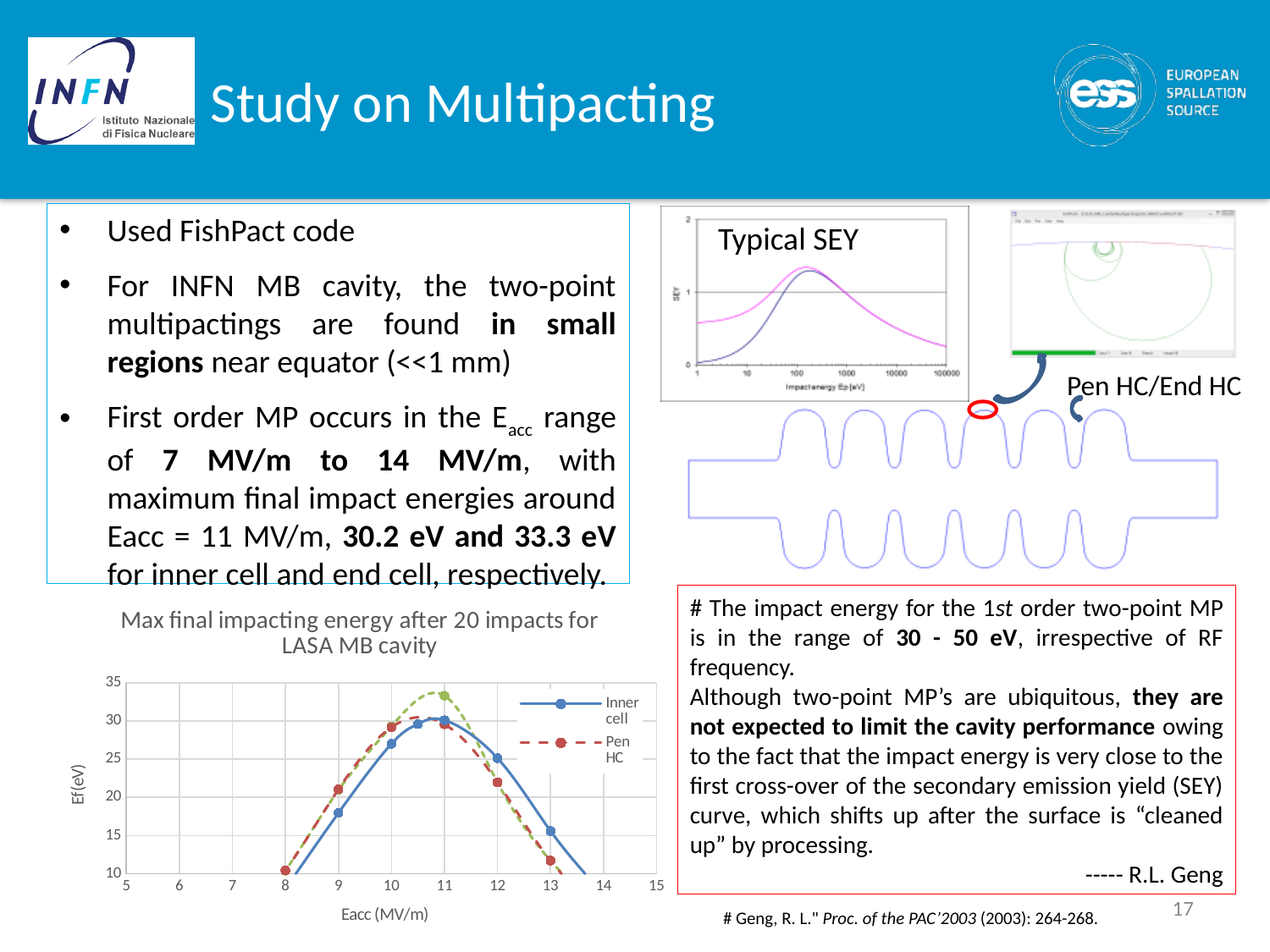
In the 'Max final impacting energy' chart, what is the y-axis title? Ef(eV) In the 'Max final impacting energy' chart, is the Inner cell value at Eacc = 10 MV/m greater or less than 25? greater In the 'Max final impacting energy' chart, which series is larger at Eacc = 9 MV/m, Inner cell or Pen HC? Pen HC In the 'Max final impacting energy' chart, does the Inner cell series rise or fall between Eacc = 8 and Eacc = 10 MV/m? rise In the 'Max final impacting energy' chart, which series is larger at Eacc = 13 MV/m, Inner cell or Pen HC? Inner cell In the 'Max final impacting energy' chart, what is the x-axis title? Eacc (MV/m) In the 'Max final impacting energy' chart, is the Inner cell value at Eacc = 9 MV/m greater or less than 20? less In the 'Max final impacting energy' chart, is the Pen HC value at Eacc = 9 MV/m greater or less than 20? greater What kind of chart is 'Max final impacting energy after 20 impacts for LASA MB cavity'? line chart How many series does the legend of the 'Max final impacting energy' chart list? 2